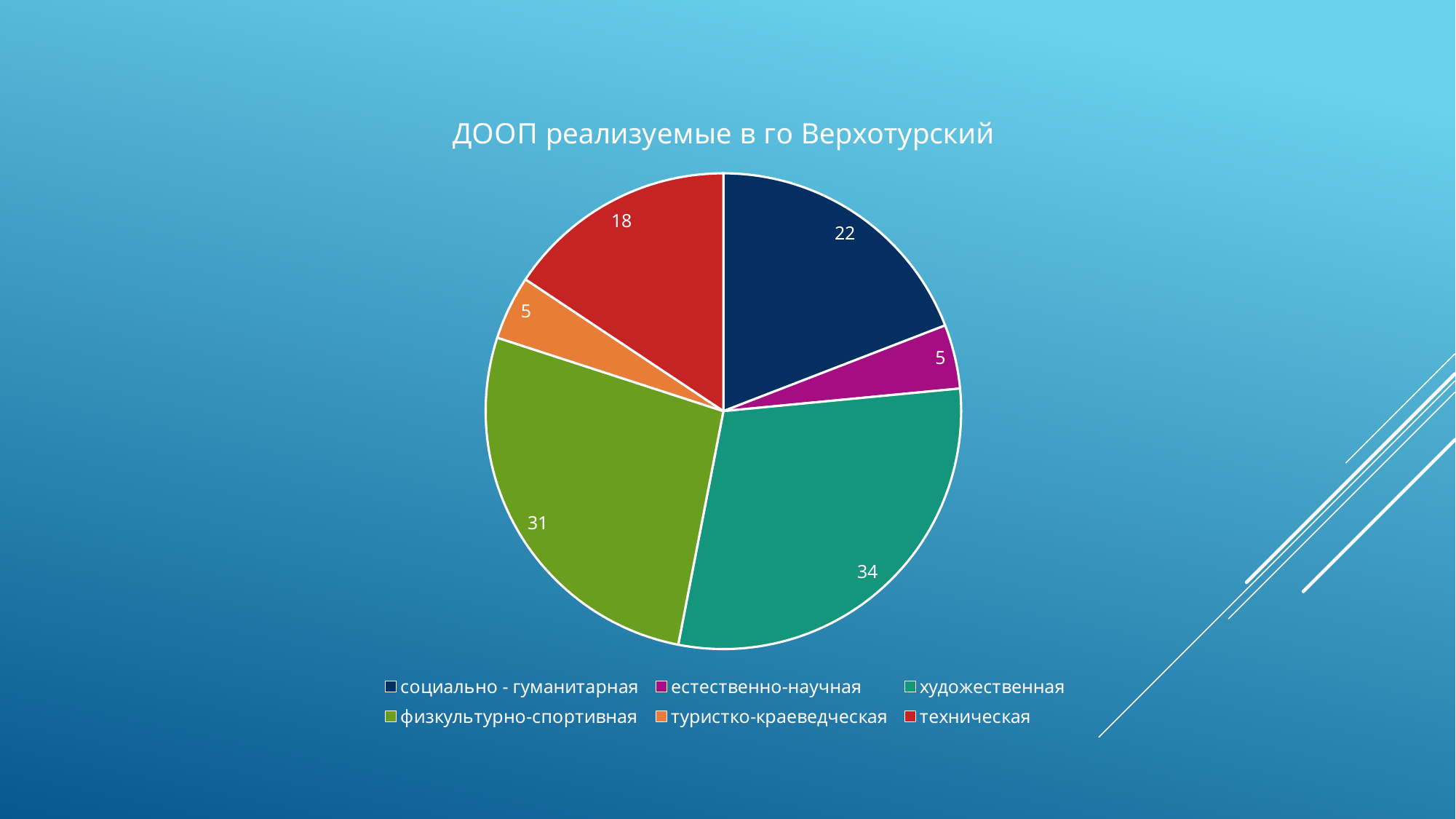
What is the title of the chart? ДООП реализуемые в го Верхотурский What is the value for социально - гуманитарная? 22 Which is larger, the value for социально - гуманитарная or the value for техническая? социально - гуманитарная What is the value for художественная? 34 Which category has the largest slice? художественная What is the value for физкультурно-спортивная? 31 What is the difference between the values for художественная and физкультурно-спортивная? 3 What type of chart is shown on the slide? pie chart What is the value for техническая? 18 What is the total of all the values shown in the pie chart? 115 How many categories does the pie chart show? 6 What is the value for туристко-краеведческая? 5